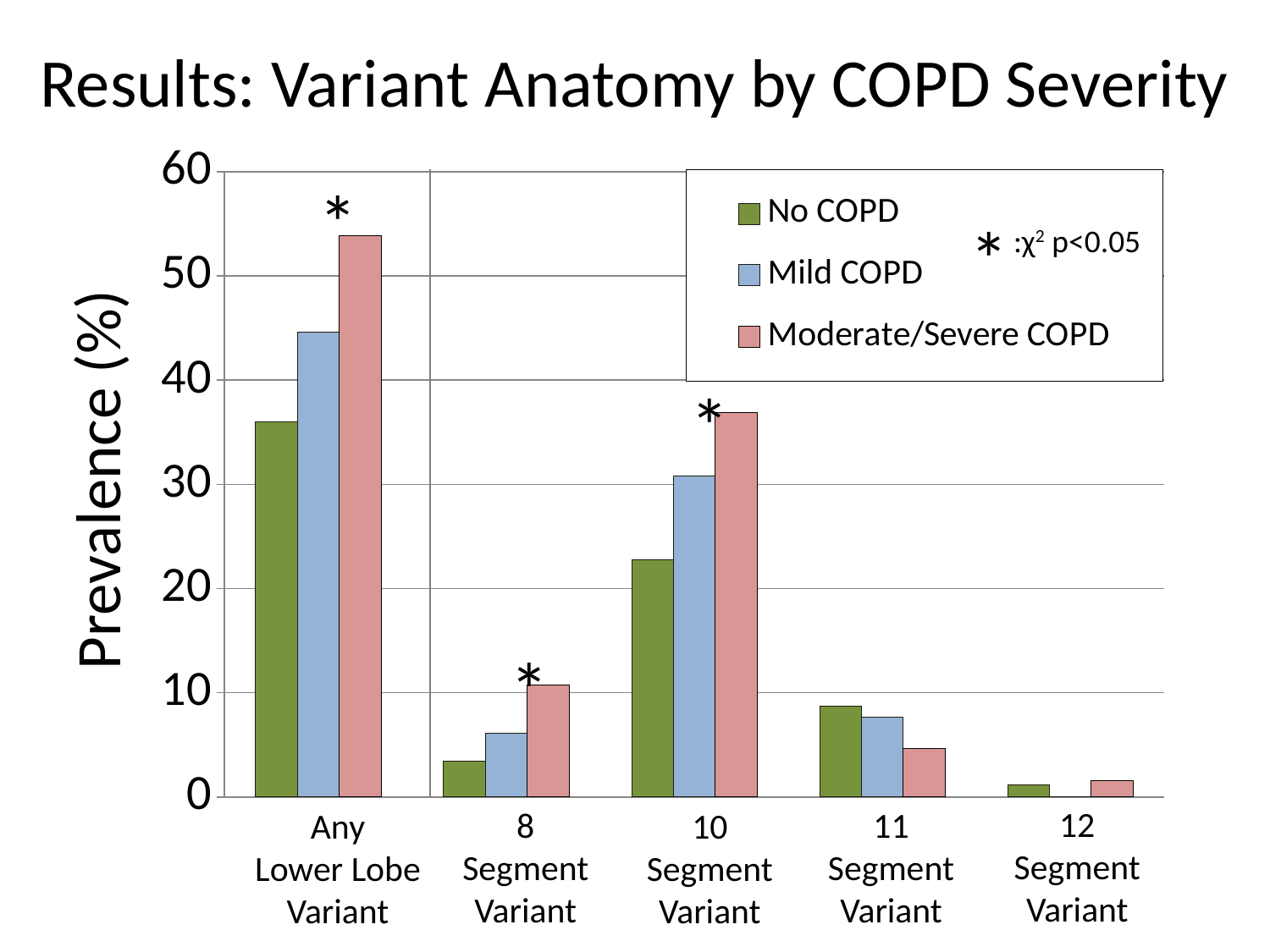
How many series does the legend list? 3 Is the Mild COPD value for 8 Segment Variant greater or less than 10? less Is the Moderate/Severe COPD value for Any Lower Lobe Variant greater or less than 50? greater Which category has the highest Moderate/Severe COPD prevalence? Any Lower Lobe Variant What is the label of the y axis? Prevalence (%) How many variant categories are shown on the x axis? 5 Which category has the lowest No COPD prevalence? 12 Segment Variant Is the No COPD value for 10 Segment Variant greater or less than 20? greater What kind of chart is shown on the slide? bar chart For 11 Segment Variant, which is larger: the No COPD value or the Moderate/Severe COPD value? No COPD For Any Lower Lobe Variant, which is larger: the Mild COPD value or the No COPD value? Mild COPD What does the asterisk above some bars indicate, according to the legend? χ² p<0.05